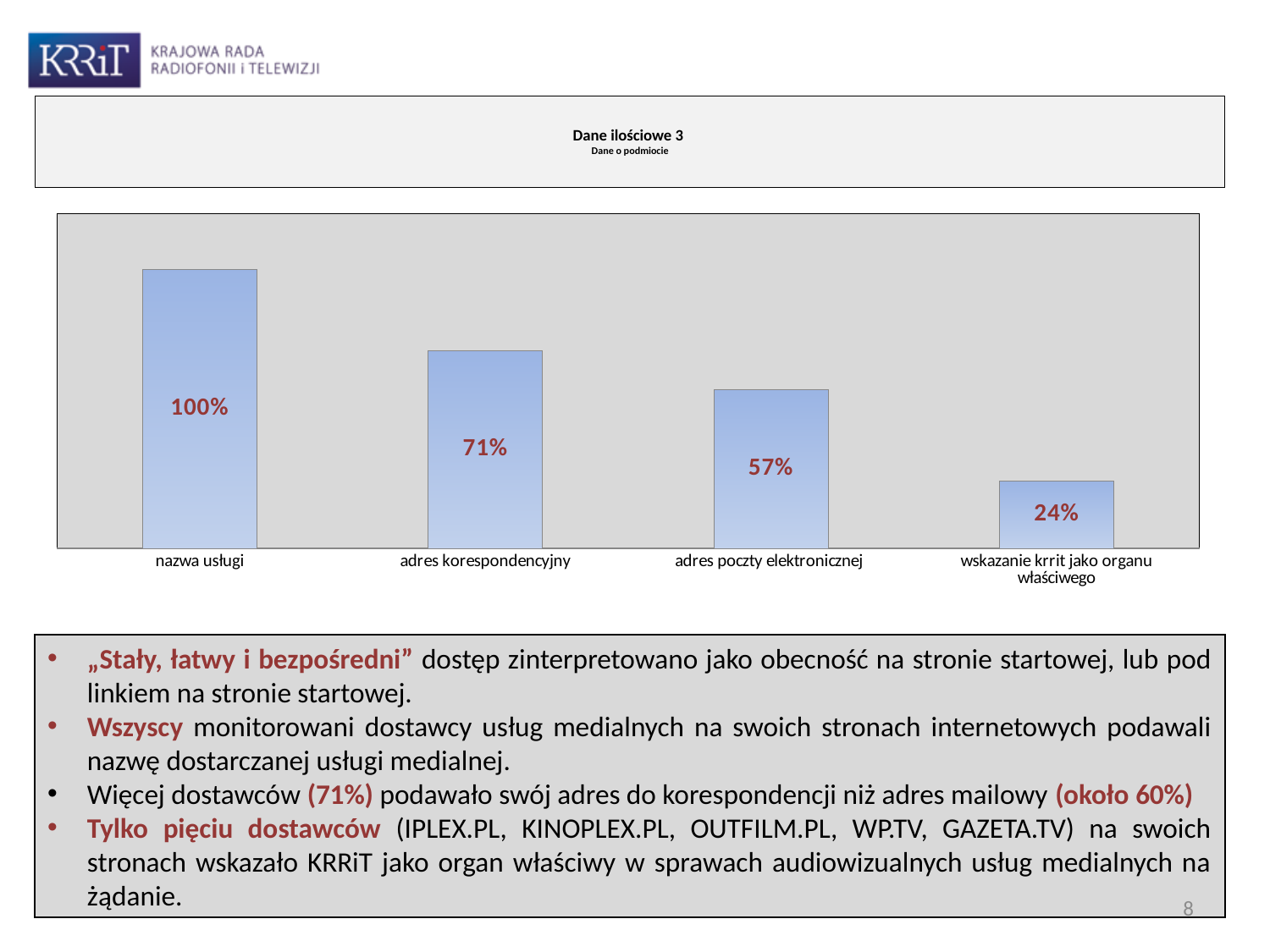
How many categories are shown in the chart? 4 Which category has the lowest value? wskazanie krrit jako organu właściwego What kind of chart is shown on the slide? bar chart What is the value for "adres korespondencyjny"? 71% What is the difference between the values for "nazwa usługi" and "wskazanie krrit jako organu właściwego"? 76% Do the values rise or fall from left to right across the categories? fall Which is larger: the value for "adres korespondencyjny" or the value for "adres poczty elektronicznej"? adres korespondencyjny Which category has the highest value? nazwa usługi What is the value for "adres poczty elektronicznej"? 57% What is the difference between the values for "adres korespondencyjny" and "adres poczty elektronicznej"? 14% What is the value for "nazwa usługi"? 100% What is the value for "wskazanie krrit jako organu właściwego"? 24%